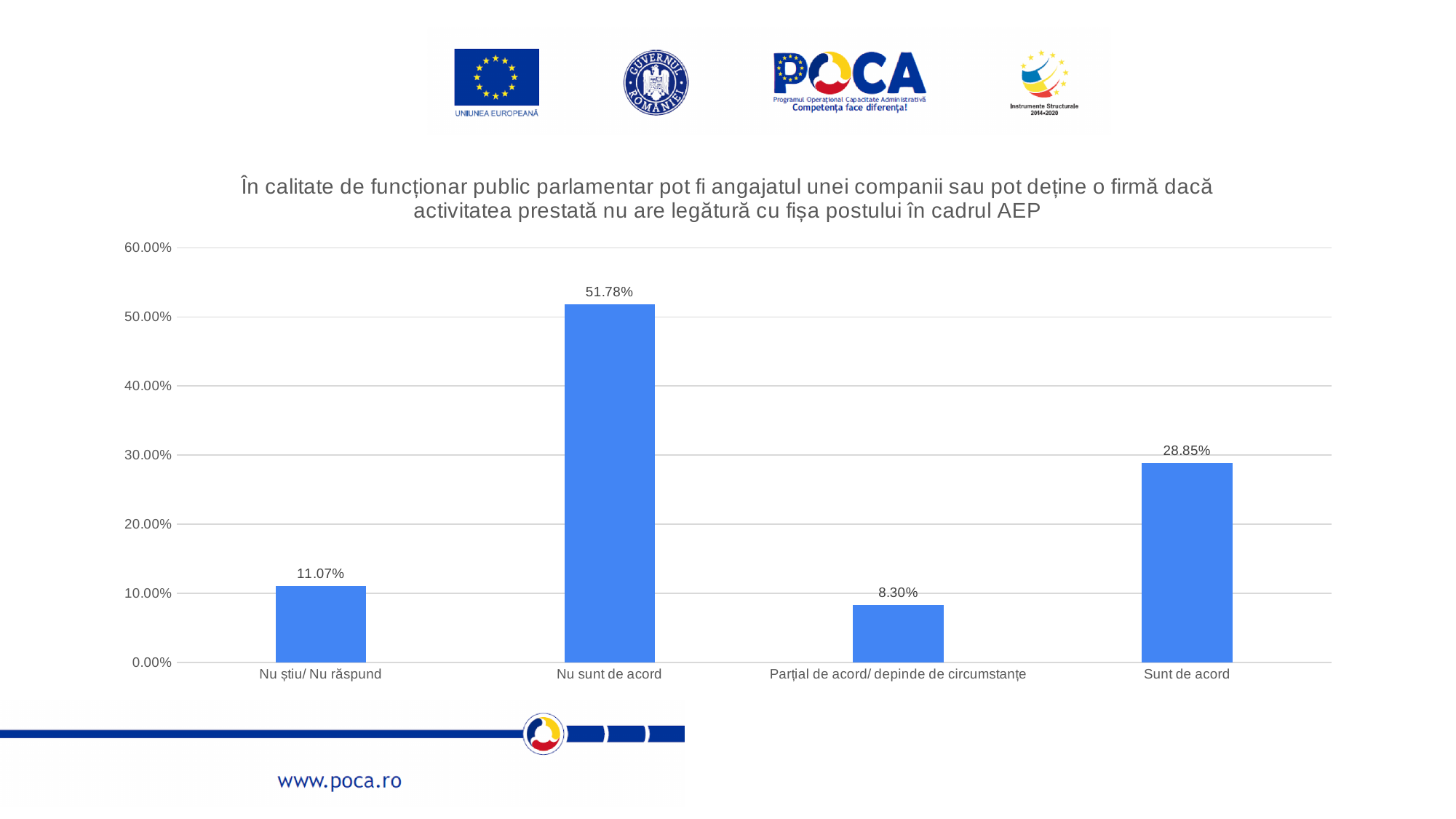
What is the highest value shown on the y axis? 60.00% What is the value for "Nu sunt de acord"? 51.78% Is the value for "Sunt de acord" greater or less than 30.00%? less What kind of chart is shown on the slide? bar chart Which is larger, the value for "Nu știu/ Nu răspund" or the value for "Parțial de acord/ depinde de circumstanțe"? Nu știu/ Nu răspund What is the value for "Parțial de acord/ depinde de circumstanțe"? 8.30% Which category has the lowest value? Parțial de acord/ depinde de circumstanțe What is the value for "Nu știu/ Nu răspund"? 11.07% Which category has the highest value? Nu sunt de acord What is the value for "Sunt de acord"? 28.85% How many categories are shown on the x axis? 4 What is the difference between the values for "Nu sunt de acord" and "Sunt de acord"? 22.93%